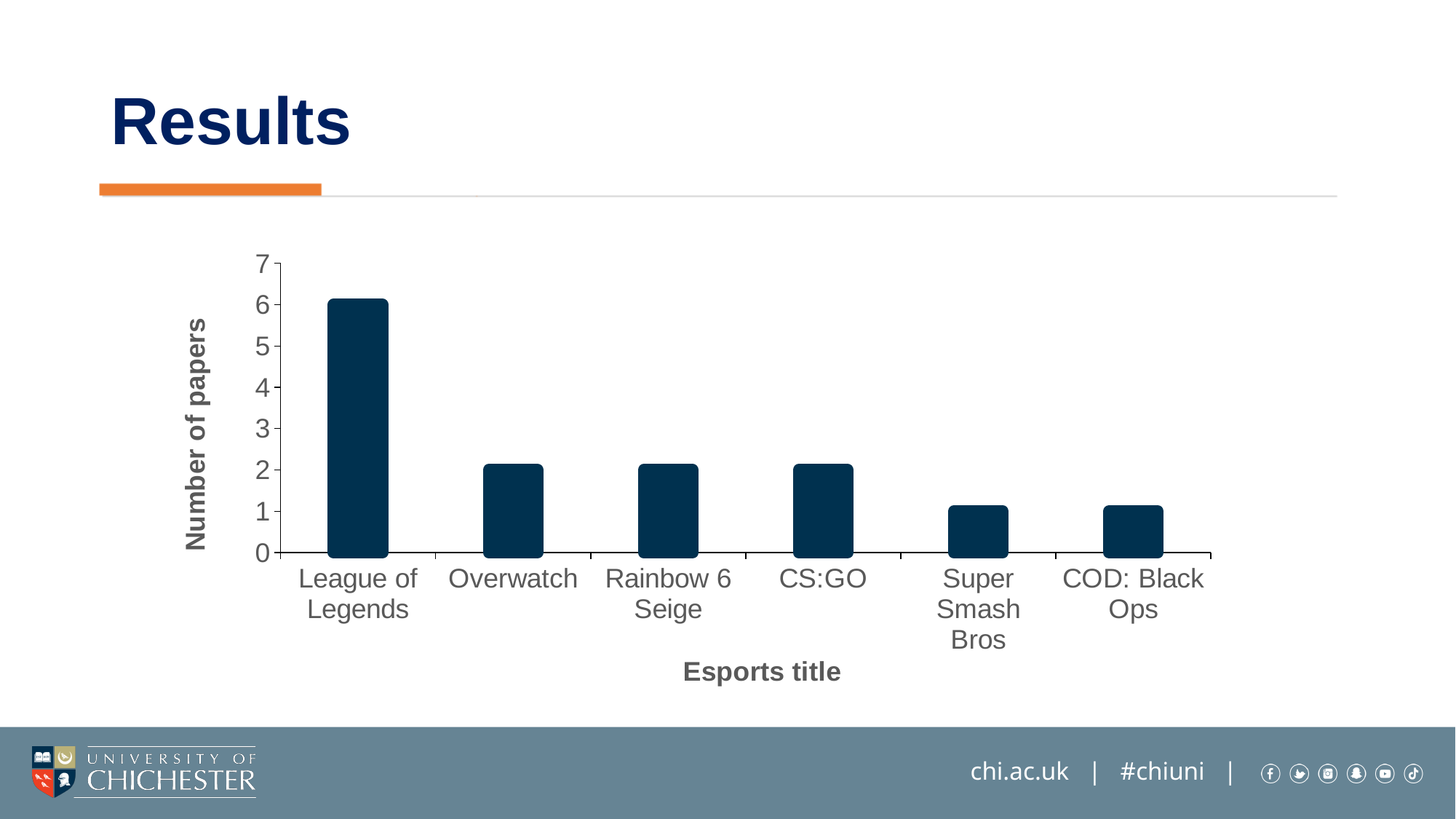
How many esports titles are shown on the x axis of the chart? 6 Is the number of papers for CS:GO greater or less than 3? less What kind of chart is shown on the slide? bar chart Which esports title has the highest number of papers? League of Legends What is the label of the y axis of the chart? Number of papers What is the difference in number of papers between League of Legends and Overwatch? 4 Which has more papers, League of Legends or Rainbow 6 Seige? League of Legends Do the values generally rise or fall moving from left to right along the x axis? fall Is the number of papers for League of Legends greater or less than 5? greater How many papers are shown for Super Smash Bros? 1 How many papers are shown for Overwatch? 2 How many papers are shown for League of Legends? 6